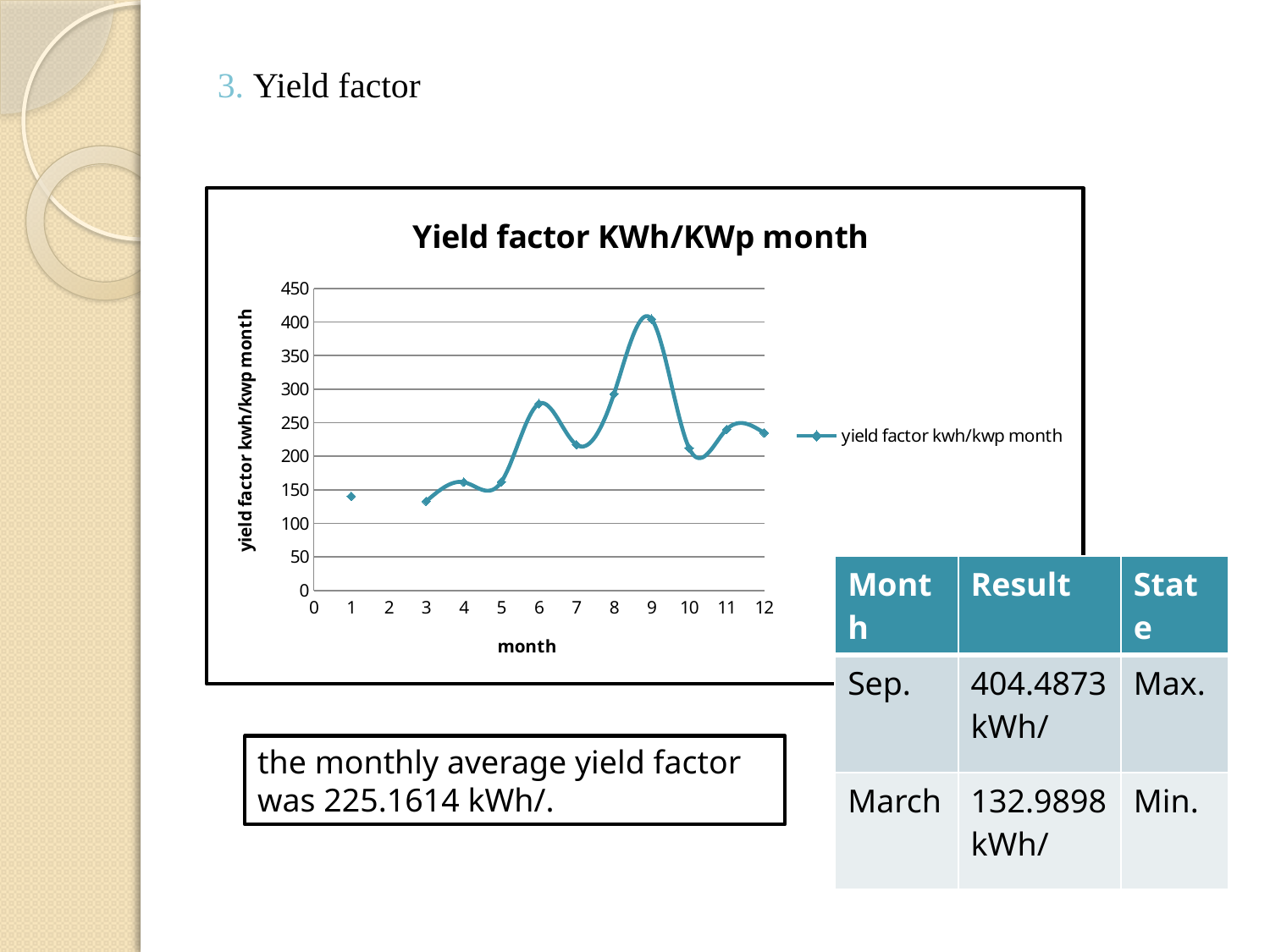
Is the yield factor for month 1 greater or less than 150? less Which has a higher yield factor, month 9 or month 6? month 9 Is the yield factor for month 12 greater or less than 250? less Does the yield factor rise or fall from month 3 to month 6? rise How many series does the chart legend list? 1 Which month has the lowest yield factor on the chart? 3 Is the yield factor for month 6 greater or less than 250? greater What is the title of the chart? Yield factor KWh/KWp month How many data points are plotted on the chart? 11 Which month has the highest yield factor on the chart? 9 What kind of chart is shown on the slide? line chart